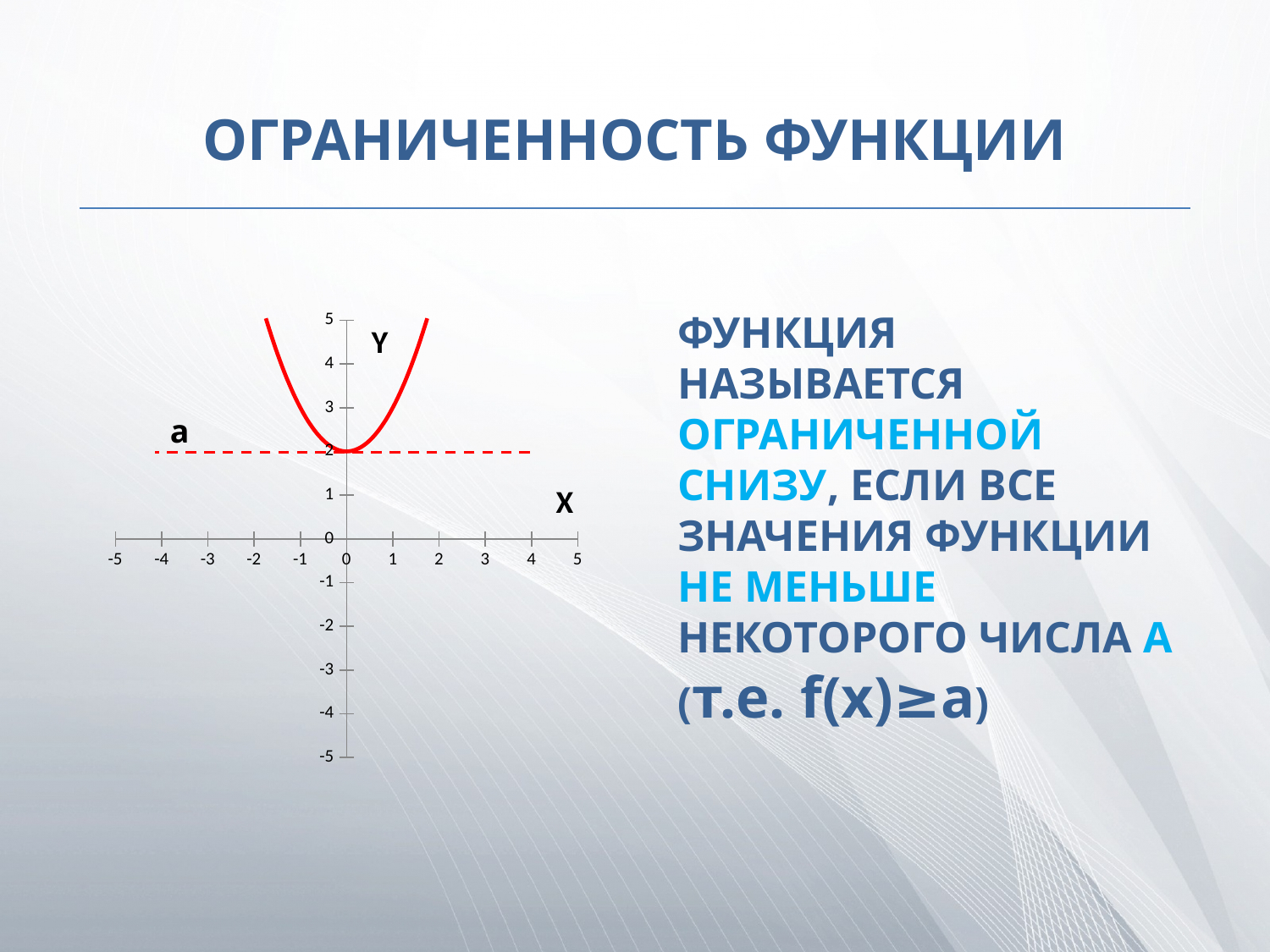
Is the value of the red curve at x = 1 greater or less than 4? less What colour is the plotted curve? red What kind of chart is shown on the slide? line chart Do the values of the red curve rise or fall as x increases from 0 to 2? rise At what y value is the dashed horizontal line labelled "a" drawn? 2 What is the lowest value the red curve reaches on the y axis? 2 Is the value of the red curve at x = 1 greater or less than 2? greater At which x value does the red curve reach its minimum? 0 What is the highest tick value shown on the x axis? 5 Is the value of the red curve at x = -1 greater or less than 2? greater Do the values of the red curve rise or fall as x increases from -2 to 0? fall How many curves are plotted on the chart? 1